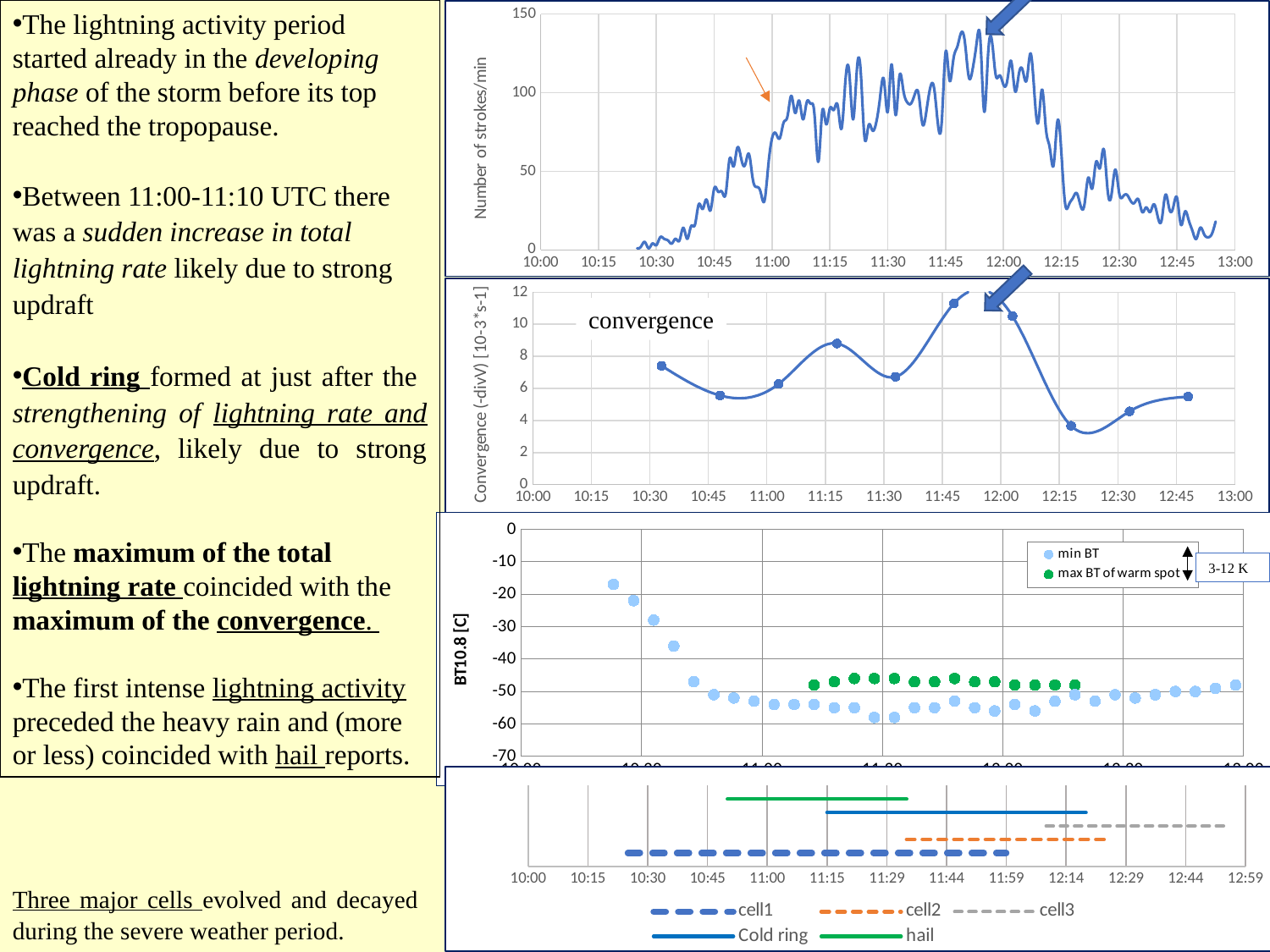
What kind of chart is the top chart showing the number of strokes per minute? line chart In the top chart (Number of strokes/min), is the peak value greater or less than 100? greater How many series does the legend of the BT10.8 [C] chart list? 2 In the top chart (Number of strokes/min), which is larger: the value around 11:45 or the value around 12:45? around 11:45 In the top chart (Number of strokes/min), is the value at the end of the series near 12:50 greater or less than 50? less In the top chart (Number of strokes/min), do the values rise or fall between 12:00 and 13:00? fall What is the y-axis title of the convergence chart? Convergence (-divV) [10-3*s-1] How many entries does the legend of the bottom timeline chart list? 5 How many data points are marked on the convergence chart? 10 In the BT10.8 [C] chart, are the 'max BT of warm spot' values greater or less than -50? greater